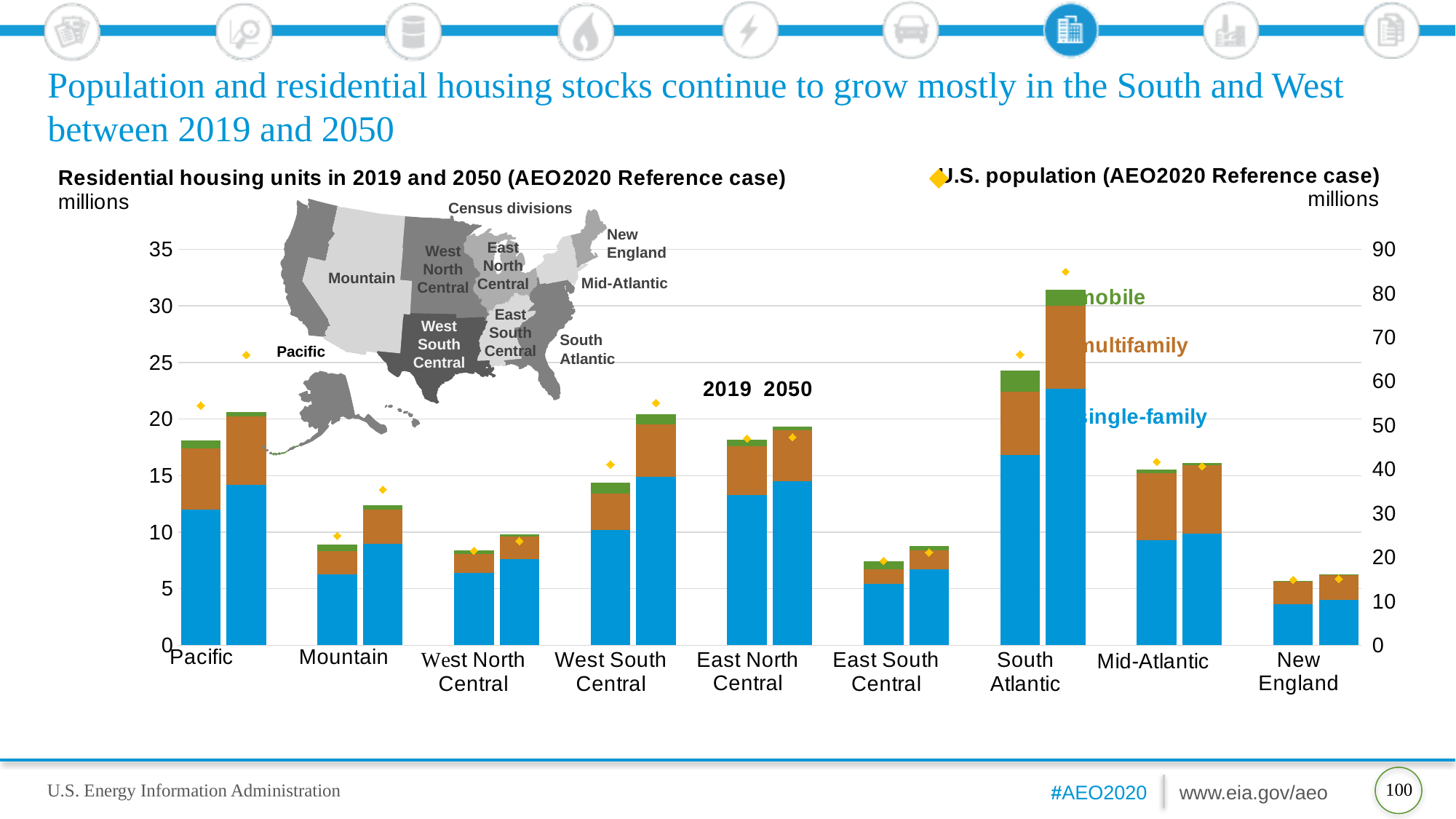
Which census division has the tallest stacked bar for 2050? South Atlantic Is the total residential housing units for East North Central in 2019 greater or less than 20 million? less Which census division has the shortest stacked bar for 2019? New England Is the total residential housing units for Mountain in 2019 greater or less than 10 million? less Is the total residential housing units for South Atlantic in 2050 greater or less than 25 million? greater How many housing types does the legend list for the stacked bars? 3 What colour represents single-family housing units in the stacked bars? blue How many census divisions are shown on the x axis of the chart? 9 What kind of chart is used to show residential housing units by census division? bar chart Which has the larger total housing units in 2050, Pacific or Mid-Atlantic? Pacific Which has the larger total housing units in 2050, Mountain or West North Central? Mountain